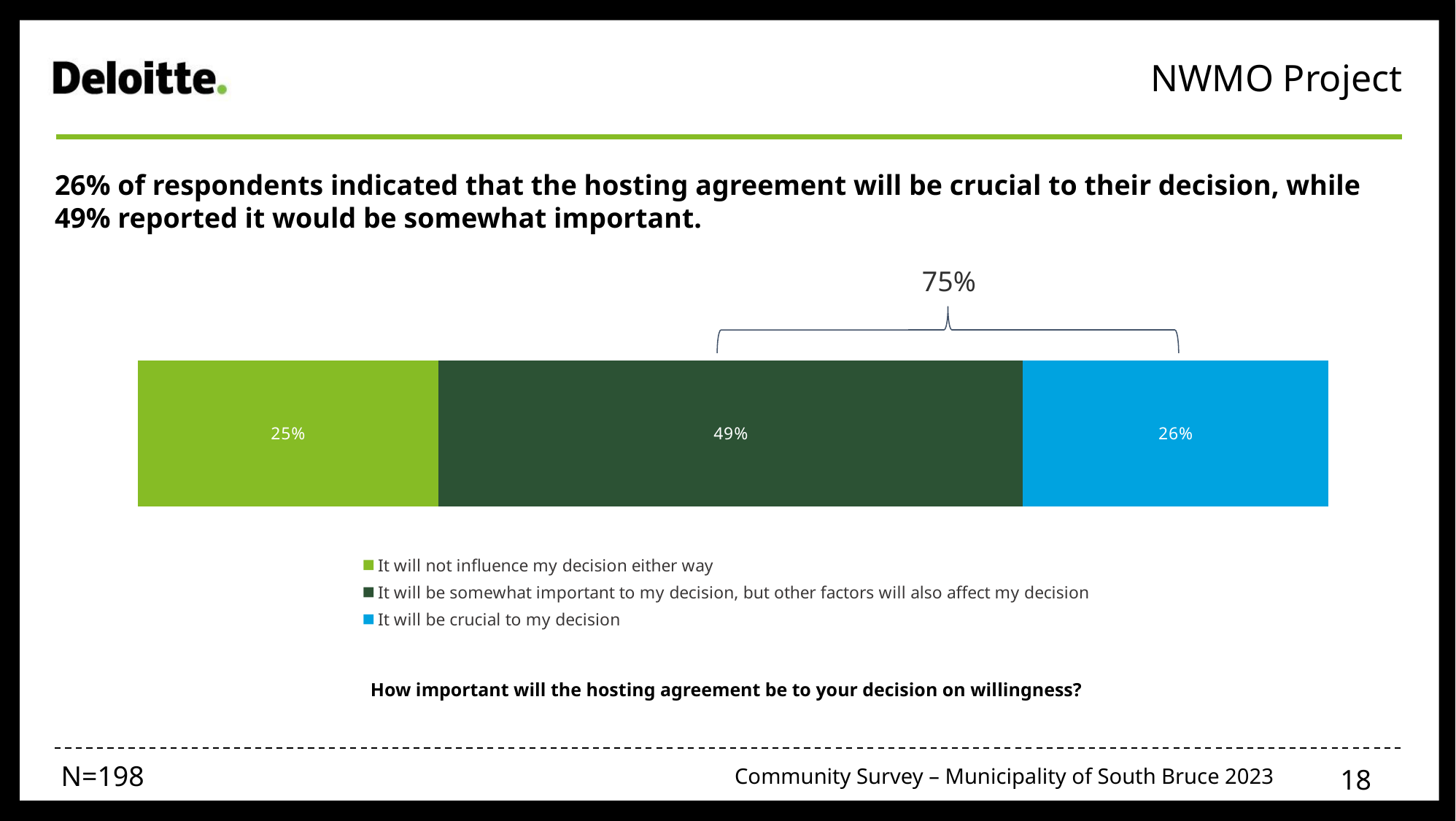
How many segments does the stacked bar contain? 3 What colour is the segment for 'It will be crucial to my decision'? Blue What percentage of respondents said the hosting agreement will not influence their decision either way? 25% What kind of chart is shown on the slide? Stacked bar chart Which response category has the largest share of respondents? It will be somewhat important to my decision, but other factors will also affect my decision What percentage of respondents said the hosting agreement will be crucial to their decision? 26% How many entries does the legend list? 3 What percentage of respondents said the hosting agreement will be somewhat important to their decision, but other factors will also affect their decision? 49% What is the difference in percentage points between the 'somewhat important' segment and the 'will not influence' segment? 24 What is the difference in percentage points between the 'somewhat important' segment and the 'crucial' segment? 23 What survey question is the chart based on? How important will the hosting agreement be to your decision on willingness? What is the combined percentage shown by the bracket above the 'somewhat important' and 'crucial' segments? 75%